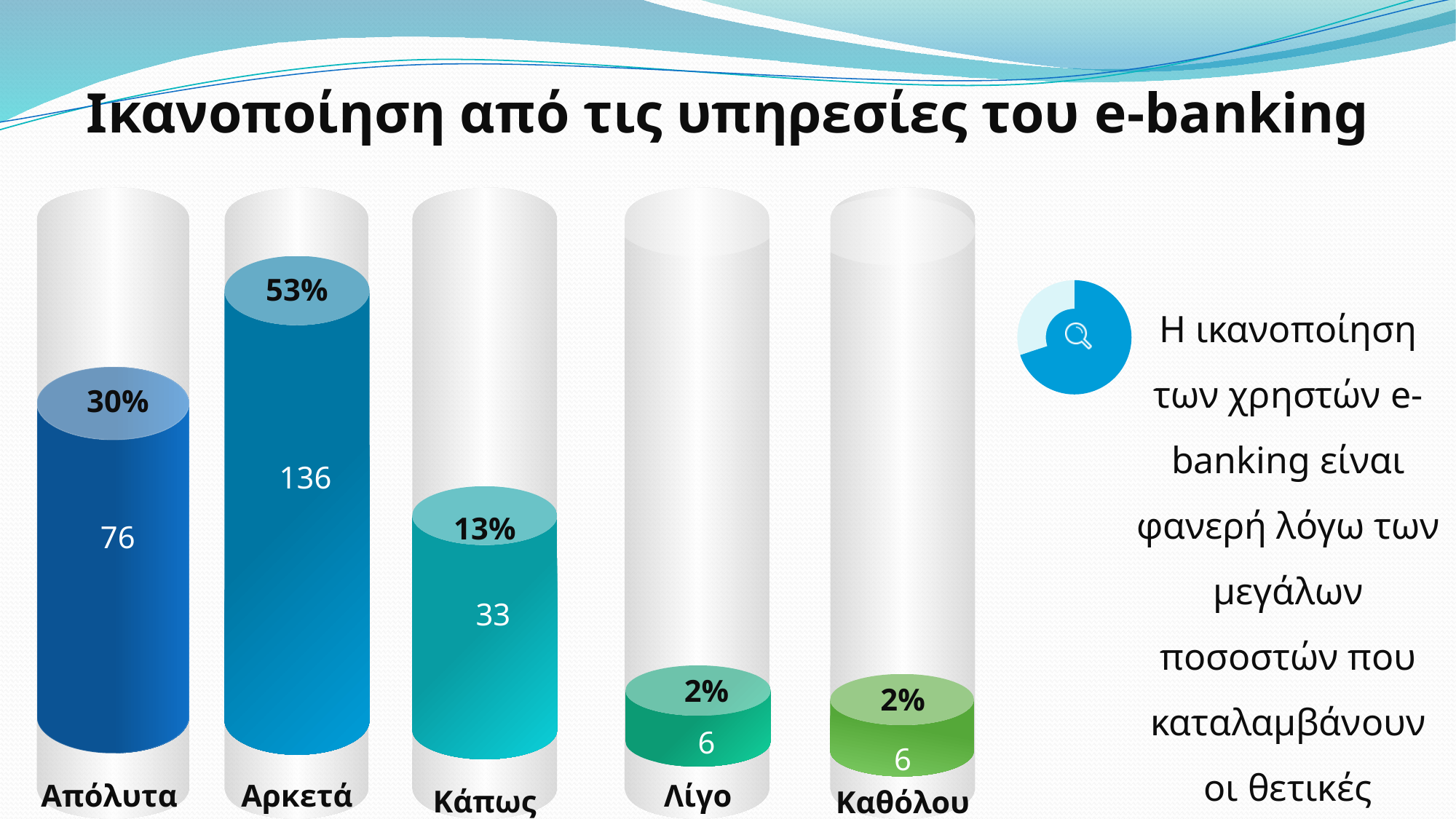
What is the count shown for the category Αρκετά? 136 What is the title of the slide? Ικανοποίηση από τις υπηρεσίες του e-banking What kind of chart is shown on the slide? Bar chart Which is larger, the count for Απόλυτα or the count for Κάπως? Απόλυτα What percentage is shown for the category Λίγο? 2% How many categories are shown in the chart? 5 Which category has the highest value? Αρκετά What is the difference in percentage points between Απόλυτα and Κάπως? 17 What is the count shown for the category Κάπως? 33 What percentage is shown for the category Απόλυτα? 30% What is the combined count for Λίγο and Καθόλου? 12 What is the difference between the counts for Αρκετά and Απόλυτα? 60